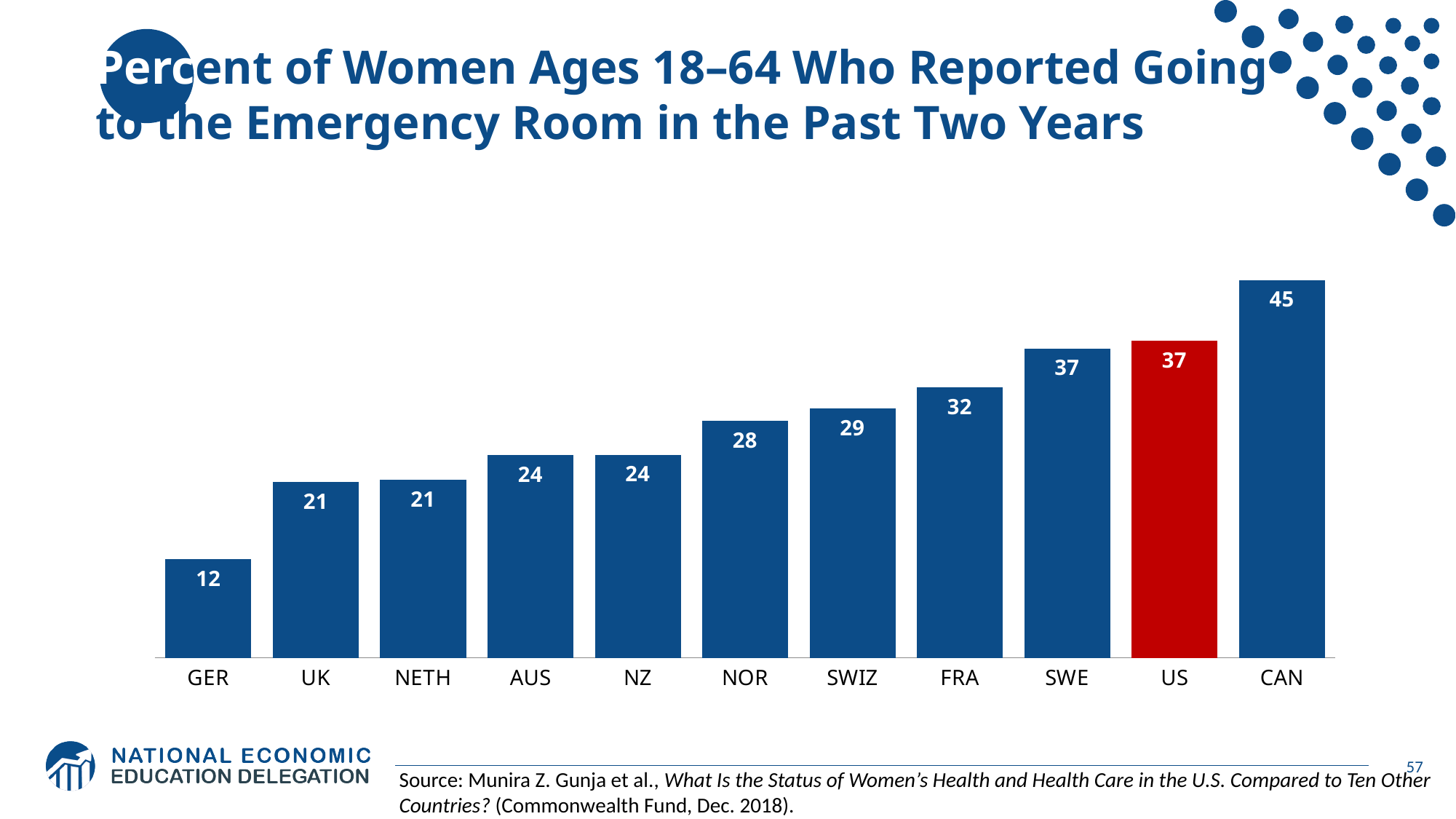
What is the difference between the values for CAN and the US? 8 Which bar is coloured red instead of blue? US What kind of chart is shown on the slide? Bar chart What is the value for NOR? 28 Which country has the highest value? CAN Which country has the lowest value? GER What is the value for the US? 37 What is the difference between the values for FRA and GER? 20 Which is larger, the value for SWIZ or the value for NZ? SWIZ Do the values rise or fall from left to right across the chart? Rise What is the value for GER? 12 How many countries are shown on the chart? 11